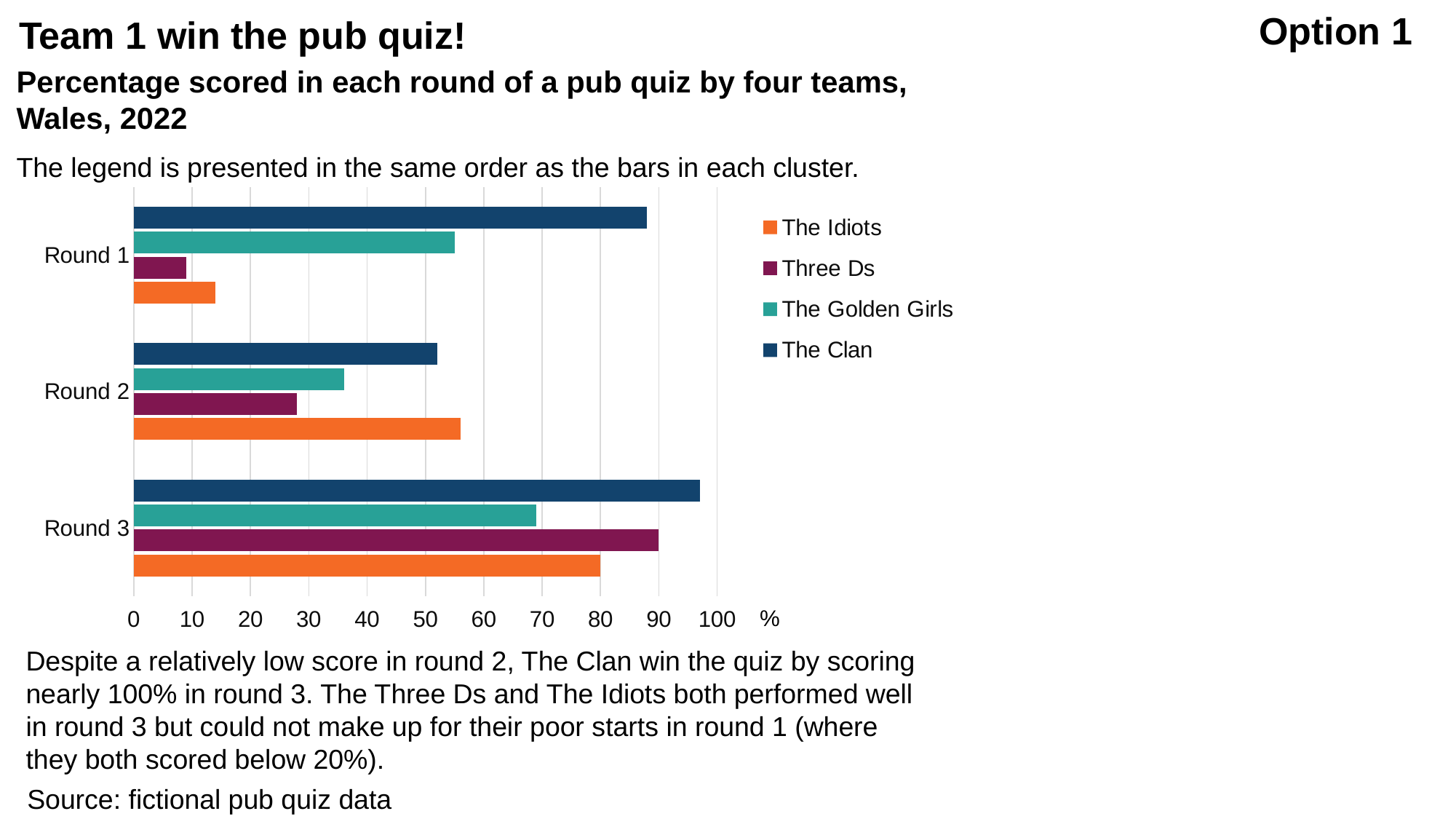
Which team scored the lowest percentage in Round 2? Three Ds Is The Golden Girls' score in Round 2 greater or less than 40? less How many teams does the legend list? 4 What kind of chart is shown on the slide? Bar chart In Round 3, which team scored higher: Three Ds or The Idiots? Three Ds Do the scores for Three Ds rise or fall from Round 1 to Round 3? rise What unit is shown on the horizontal axis of the chart? % Which team scored the lowest percentage in Round 1? Three Ds Which team scored the highest percentage in Round 3? The Clan How many rounds (categories) are shown on the chart? 3 Is The Idiots' score in Round 1 greater or less than 20? less Is The Clan's score in Round 3 greater or less than 90? greater